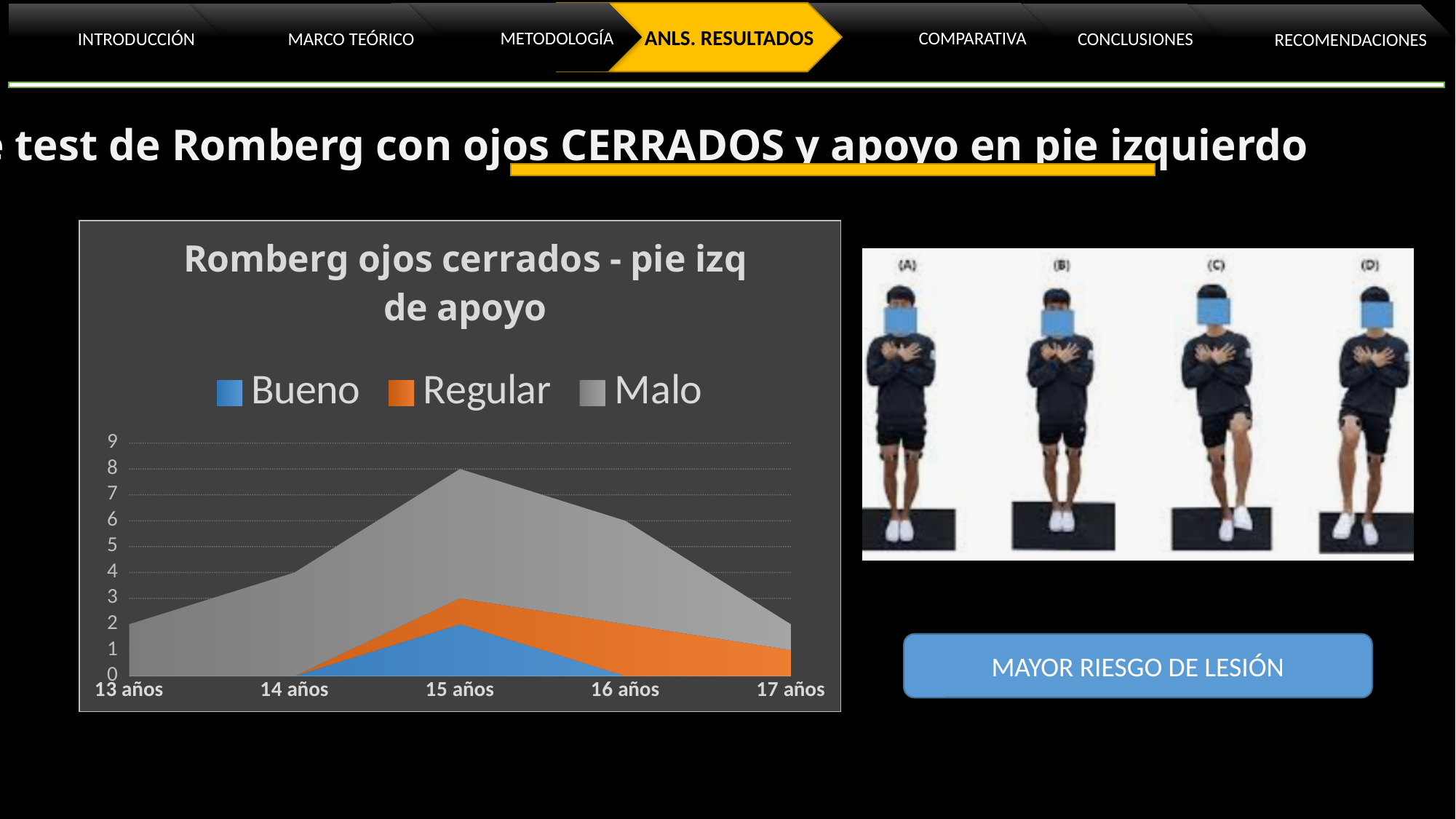
Is the Bueno value for 15 años greater or less than 4? less Is the total stacked value for 17 años greater or less than 4? less Which series are listed in the chart legend? Bueno, Regular, Malo Is the total stacked value for 13 años greater or less than 5? less What is the title of the chart? Romberg ojos cerrados - pie izq de apoyo How many age categories are shown on the x axis of the chart? 5 Does the total stacked value rise or fall from 15 años to 17 años? fall Which has a larger total stacked value, 16 años or 17 años? 16 años Which age category has the highest total stacked value in the chart? 15 años What type of chart is shown on the slide? Area chart How many series does the chart legend list? 3